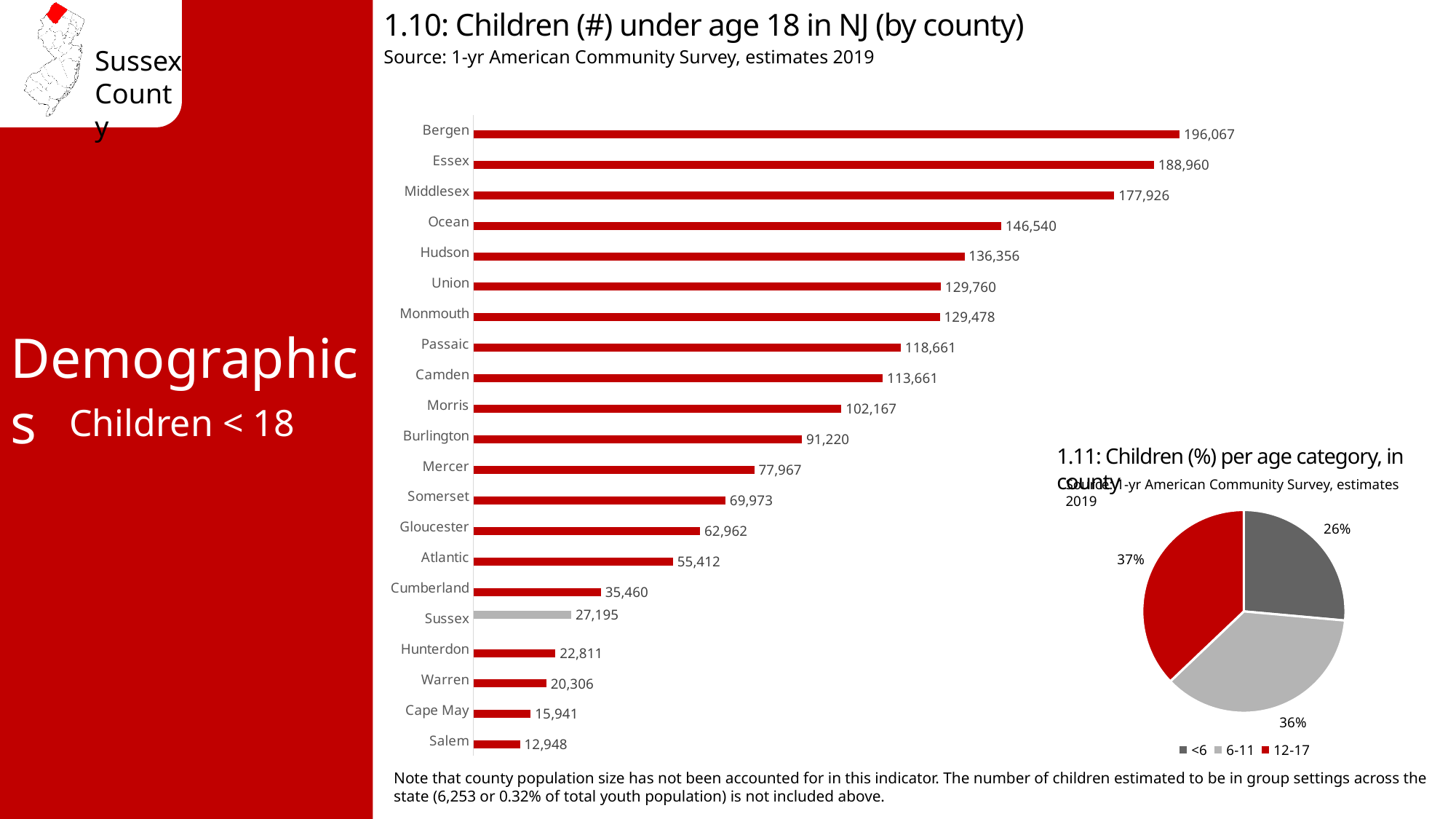
In the chart '1.10: Children (#) under age 18 in NJ (by county)', what is the difference between Bergen and Essex? 7,107 How many categories does the legend of the pie chart '1.11: Children (%) per age category, in county' list? 3 In the chart '1.10: Children (#) under age 18 in NJ (by county)', which county has the lowest number of children under 18? Salem In the chart '1.10: Children (#) under age 18 in NJ (by county)', what is the value for Ocean? 146,540 In the chart '1.10: Children (#) under age 18 in NJ (by county)', which county has the highest number of children under 18? Bergen In the chart '1.10: Children (#) under age 18 in NJ (by county)', how many children under 18 are in Sussex? 27,195 In the chart '1.10: Children (#) under age 18 in NJ (by county)', which has more children under 18, Hunterdon or Warren? Hunterdon What type of chart is '1.10: Children (#) under age 18 in NJ (by county)'? Bar chart In the pie chart '1.11: Children (%) per age category, in county', which age category has the smallest share? <6 In the chart '1.10: Children (#) under age 18 in NJ (by county)', which county's bar is shown in grey instead of red? Sussex How many counties are shown in the chart '1.10: Children (#) under age 18 in NJ (by county)'? 21 In the pie chart '1.11: Children (%) per age category, in county', what share is the 12-17 age category? 37%